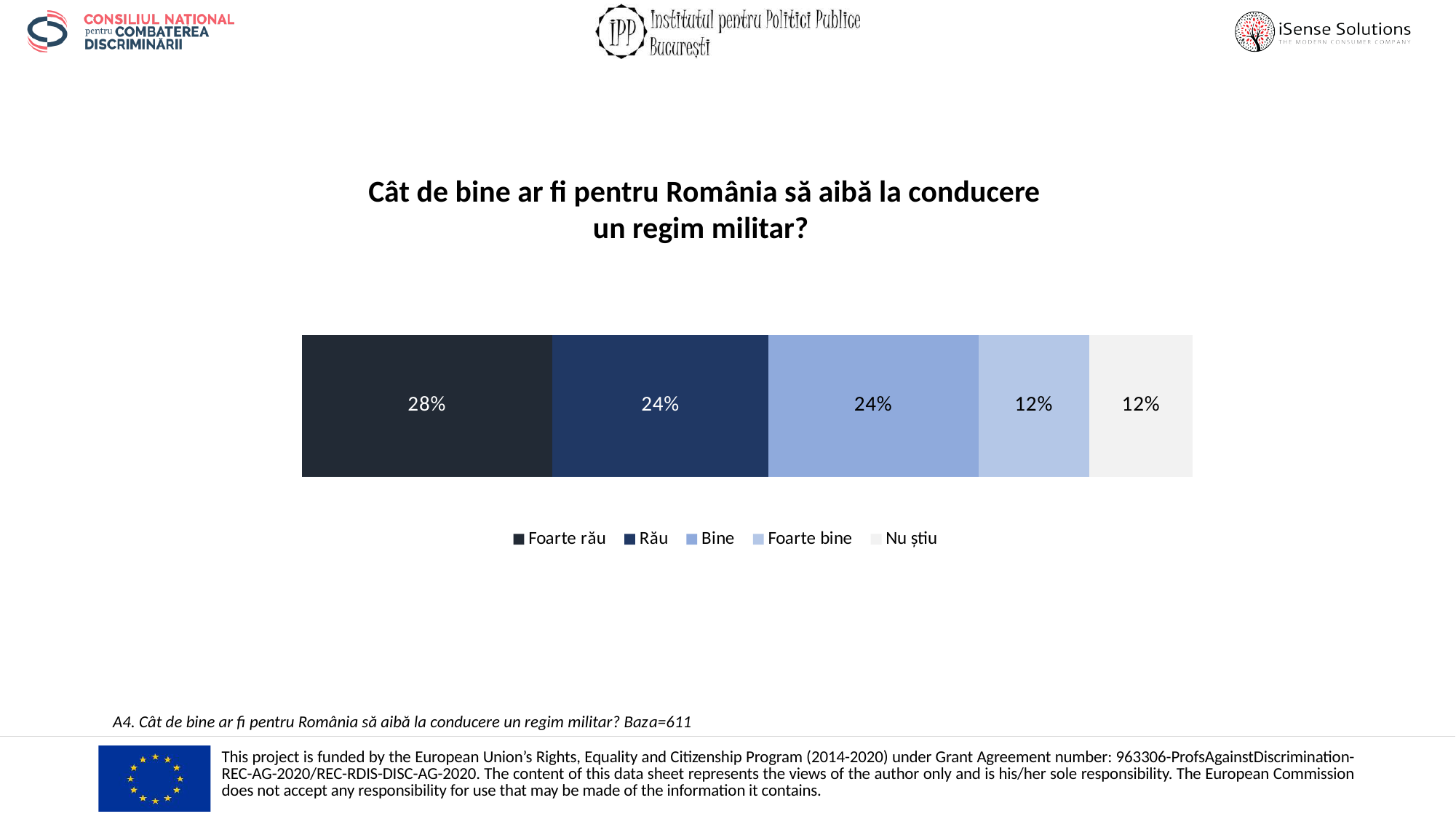
What is the difference between the "Foarte rău" and "Bine" percentages? 4% What is the value shown for "Rău"? 24% What is the title of the chart? Cât de bine ar fi pentru România să aibă la conducere un regim militar? What percentage is shown for "Foarte bine"? 12% What is the value for "Nu știu"? 12% What percentage of respondents answered "Foarte rău"? 28% Which is larger, the value for "Foarte rău" or the value for "Foarte bine"? Foarte rău Which response category has the highest percentage? Foarte rău What kind of chart is shown on the slide? Stacked bar chart What is the total of all segments in the stacked bar? 100% What is the difference between the "Rău" and "Foarte bine" percentages? 12% How many series does the legend list? 5